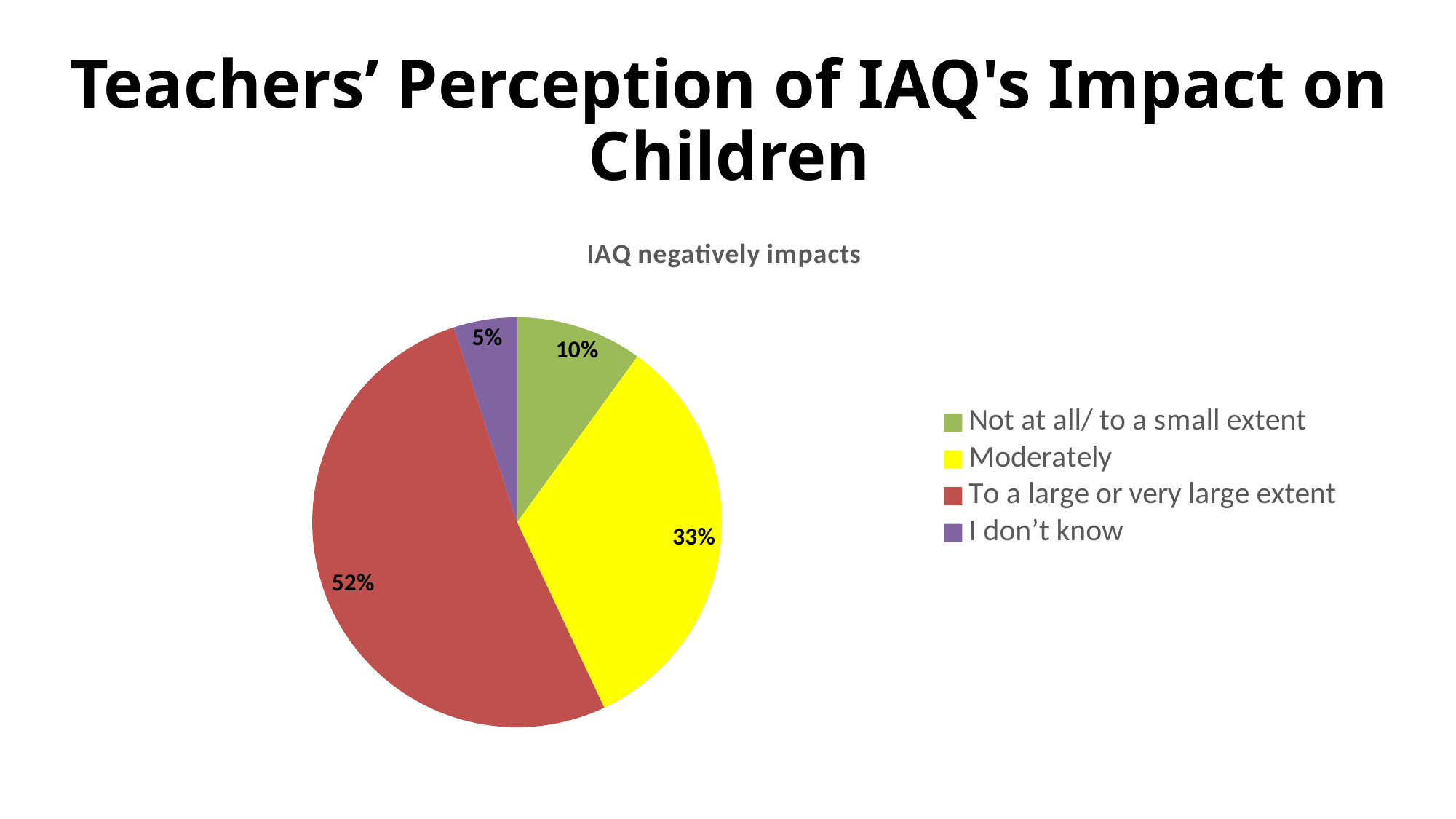
What percentage of teachers answered 'I don't know'? 5% What type of chart is shown on the slide? pie chart Which category has the smallest share of the pie? I don't know What percentage of teachers answered 'Moderately'? 33% What is the chart's title? IAQ negatively impacts What percentage of teachers answered 'To a large or very large extent'? 52% What is the difference between the 'To a large or very large extent' share and the 'Moderately' share? 19% What colour is the 'Moderately' slice? yellow How many categories does the pie chart have? 4 Which category has the largest share of the pie? To a large or very large extent What percentage of teachers answered 'Not at all/ to a small extent'? 10% Which is larger, the 'Moderately' share or the 'Not at all/ to a small extent' share? Moderately